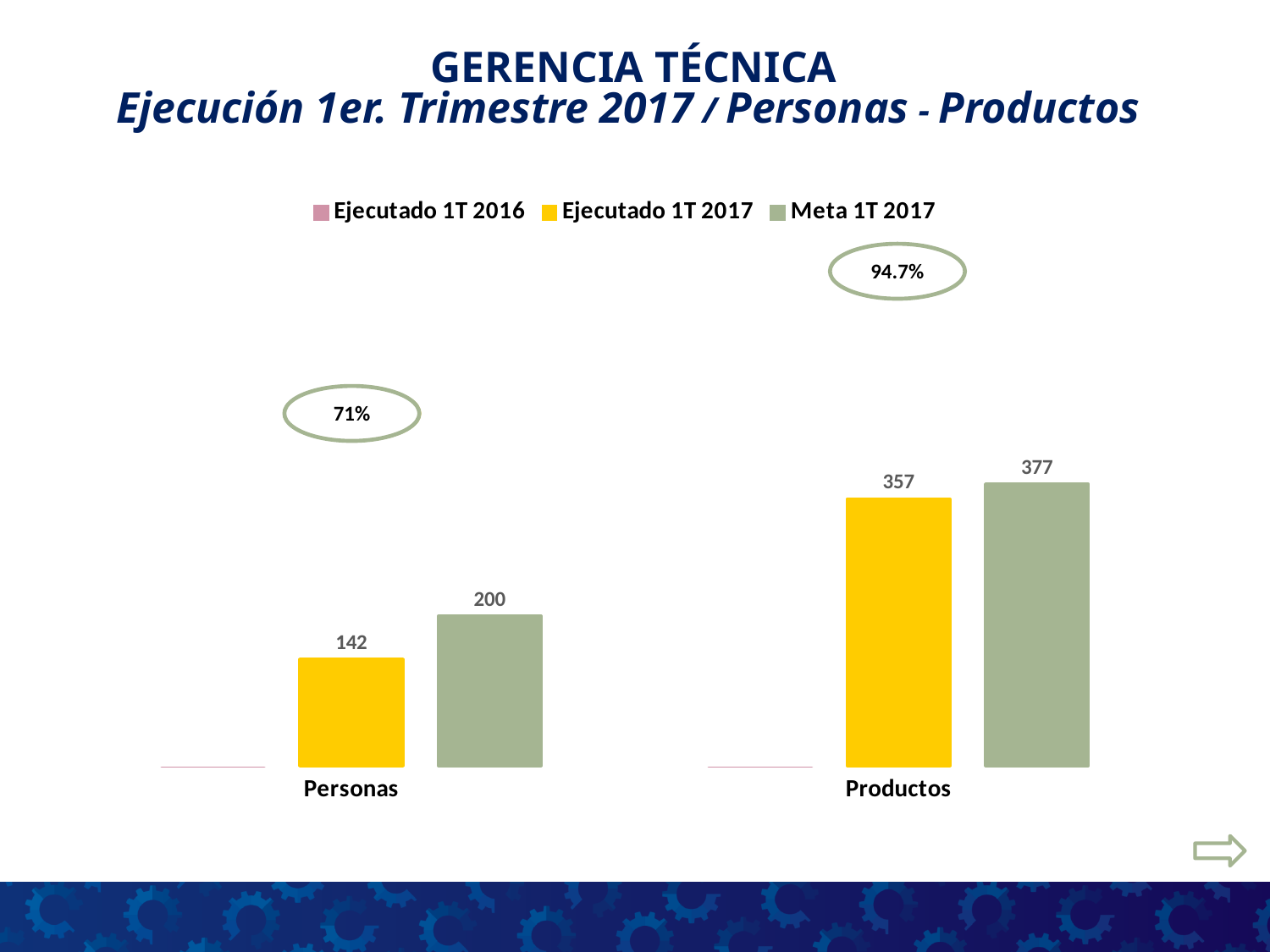
What is the Meta 1T 2017 value for Personas? 200 What is the Meta 1T 2017 value for Productos? 377 How many series does the legend list? 3 What is the difference between the Meta 1T 2017 and Ejecutado 1T 2017 values for Productos? 20 What is the Ejecutado 1T 2017 value for Productos? 357 Which category has the lowest Meta 1T 2017 value? Personas How many categories are shown on the x axis? 2 Which category has the highest Ejecutado 1T 2017 value? Productos What is the Ejecutado 1T 2017 value for Personas? 142 What percentage is shown in the oval above the Productos bars? 94.7% Is the Ejecutado 1T 2017 value for Productos larger or smaller than the Meta 1T 2017 value for Productos? smaller What is the difference between the Meta 1T 2017 and Ejecutado 1T 2017 values for Personas? 58